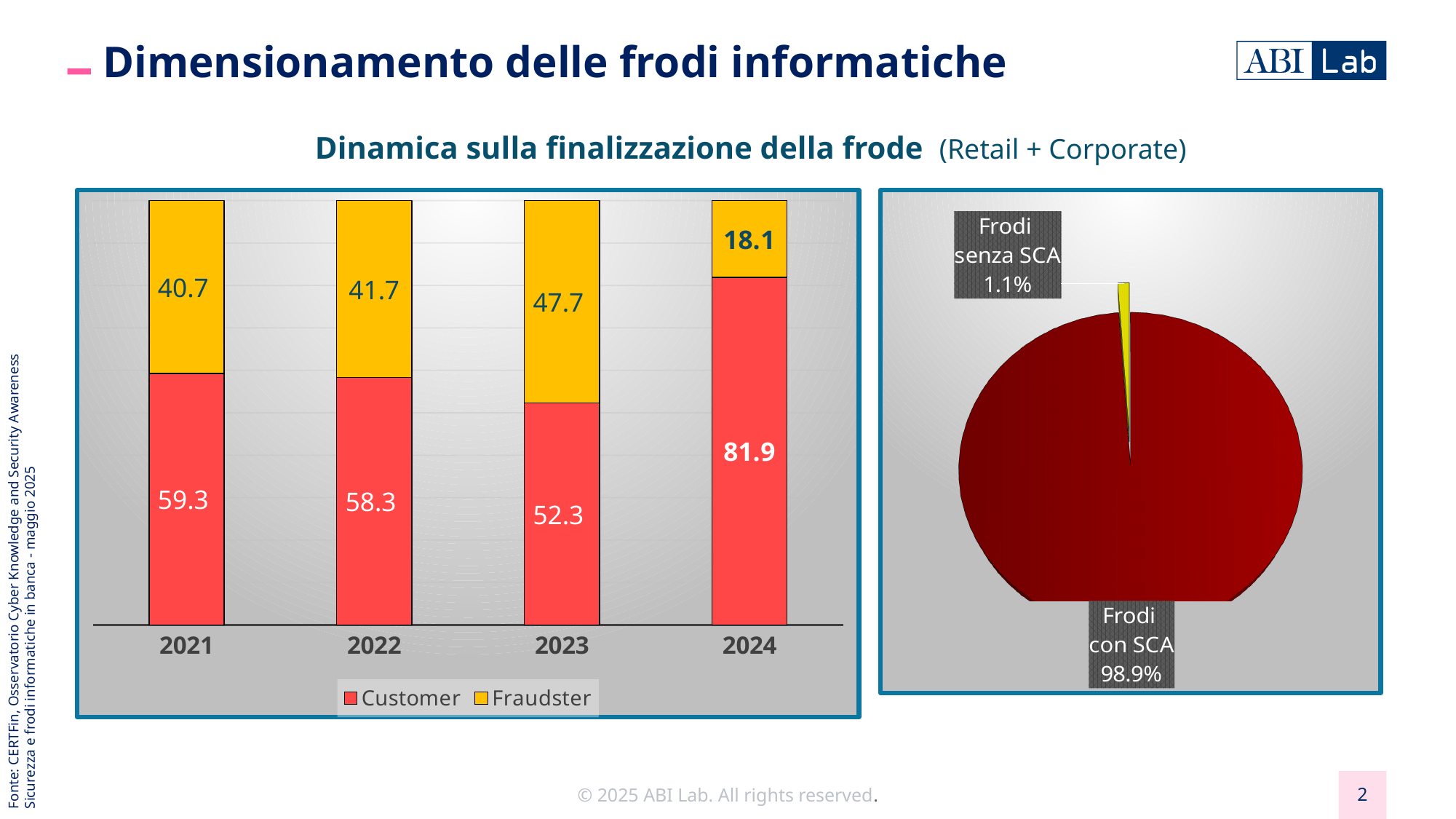
In the pie chart on the right, what share is labelled Frodi con SCA? 98.9% In the stacked bar chart on the left, what is the Customer value for 2024? 81.9 In the stacked bar chart on the left, which year has the highest Fraudster value? 2023 In the stacked bar chart on the left, what is the Fraudster value for 2023? 47.7 In the stacked bar chart on the left, what is the difference between the Customer and Fraudster values in 2024? 63.8 In the stacked bar chart on the left, what is the total of the 2022 bar? 100 In the stacked bar chart on the left, how many years are shown on the x axis? 4 In the stacked bar chart on the left, how many series does the legend list? 2 What kind of chart is shown on the right side of the slide? pie chart In the stacked bar chart on the left, is the Fraudster value larger in 2021 or in 2022? 2022 In the stacked bar chart on the left, does the Customer value rise or fall from 2021 to 2023? fall In the stacked bar chart on the left, which year has the lowest Customer value? 2023